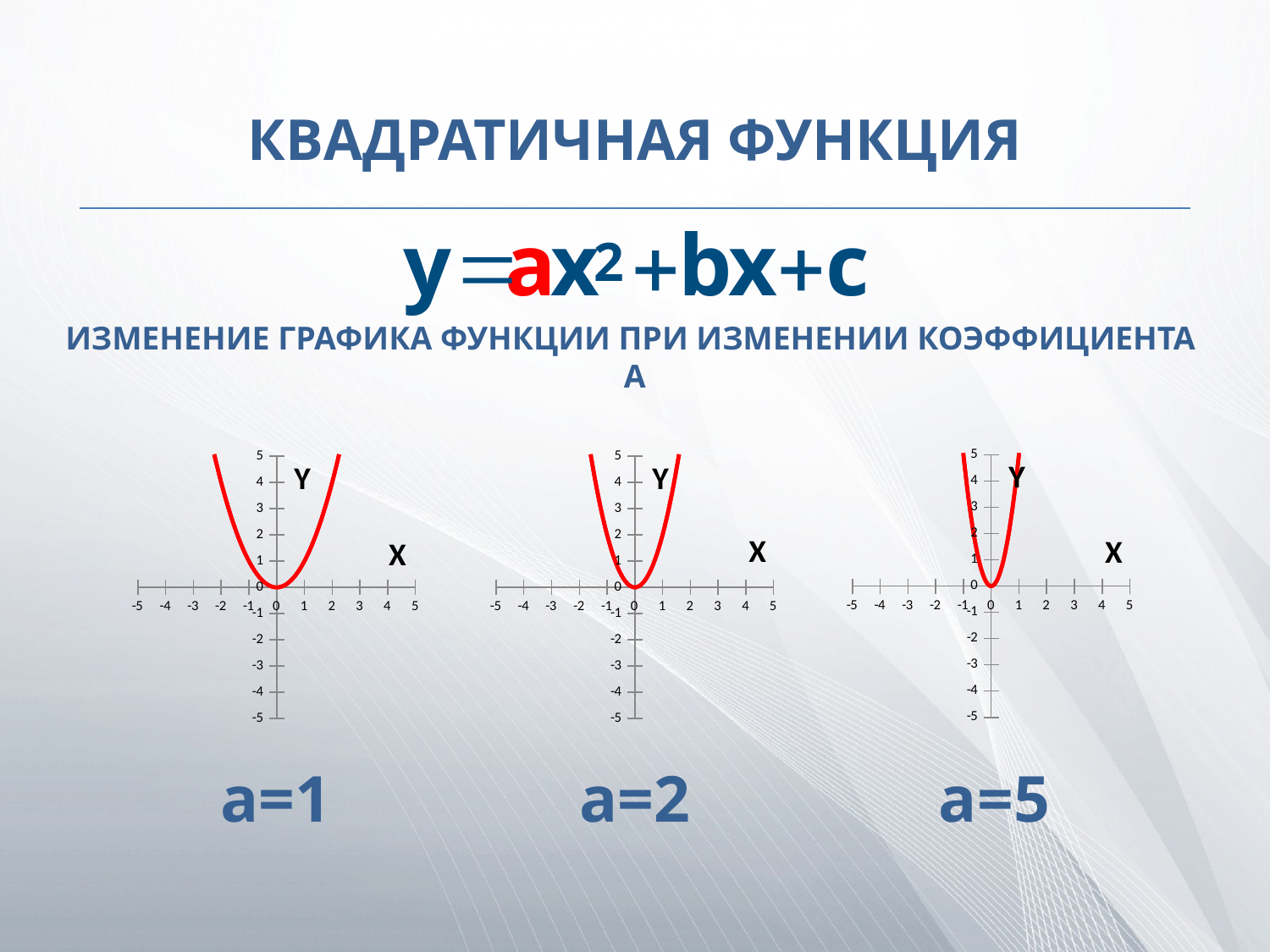
How many charts are shown on the slide? 3 Which of the three charts shows the narrowest parabola? a=5 In the a=2 chart, is the value of the curve at x=1 greater or less than 1? greater What is the lowest value shown on the horizontal axis of the a=2 chart? -5 In the a=5 chart, does the curve rise or fall as x increases from -1 to 0? falls In the a=1 chart, is the value of the curve at x=2 greater or less than 3? greater What is the highest value shown on the vertical axis of the a=1 chart? 5 In the a=1 chart, at what x value does the curve reach its minimum? 0 In the a=1 chart, does the curve rise or fall as x increases from 0 to 2? rises In the a=5 chart, what is the minimum y value the curve reaches? 0 What kind of chart is shown in the left chart labelled a=1? line chart Which of the three charts shows the widest parabola? a=1